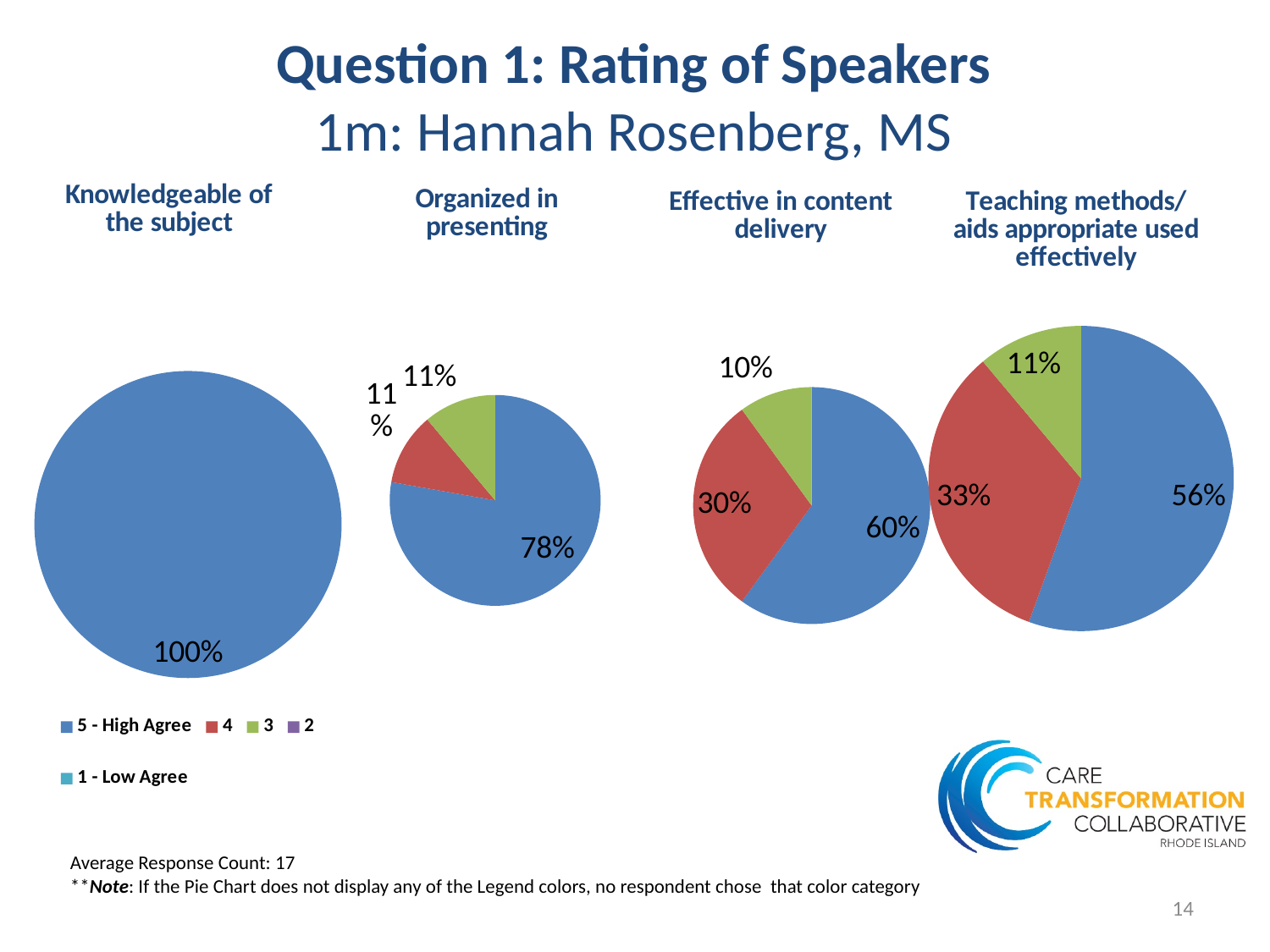
In the 'Effective in content delivery' pie chart, which rating category has the smallest slice? 3 What type of chart is used for 'Effective in content delivery'? Pie chart How many slices does the 'Organized in presenting' pie chart have? 3 Which is larger: the '5 - High Agree' share in the 'Organized in presenting' chart or in the 'Teaching methods/aids appropriate used effectively' chart? Organized in presenting In the 'Effective in content delivery' pie chart, what is the difference between the '5 - High Agree' share and the '4' share? 30% In the 'Teaching methods/aids appropriate used effectively' pie chart, what share of responses is '5 - High Agree'? 56% How many rating categories does the legend list? 5 In the 'Knowledgeable of the subject' pie chart, what share of responses is '5 - High Agree'? 100% In the 'Effective in content delivery' pie chart, which rating category has the largest slice? 5 - High Agree In the 'Teaching methods/aids appropriate used effectively' pie chart, what share of responses is rated '3'? 11%